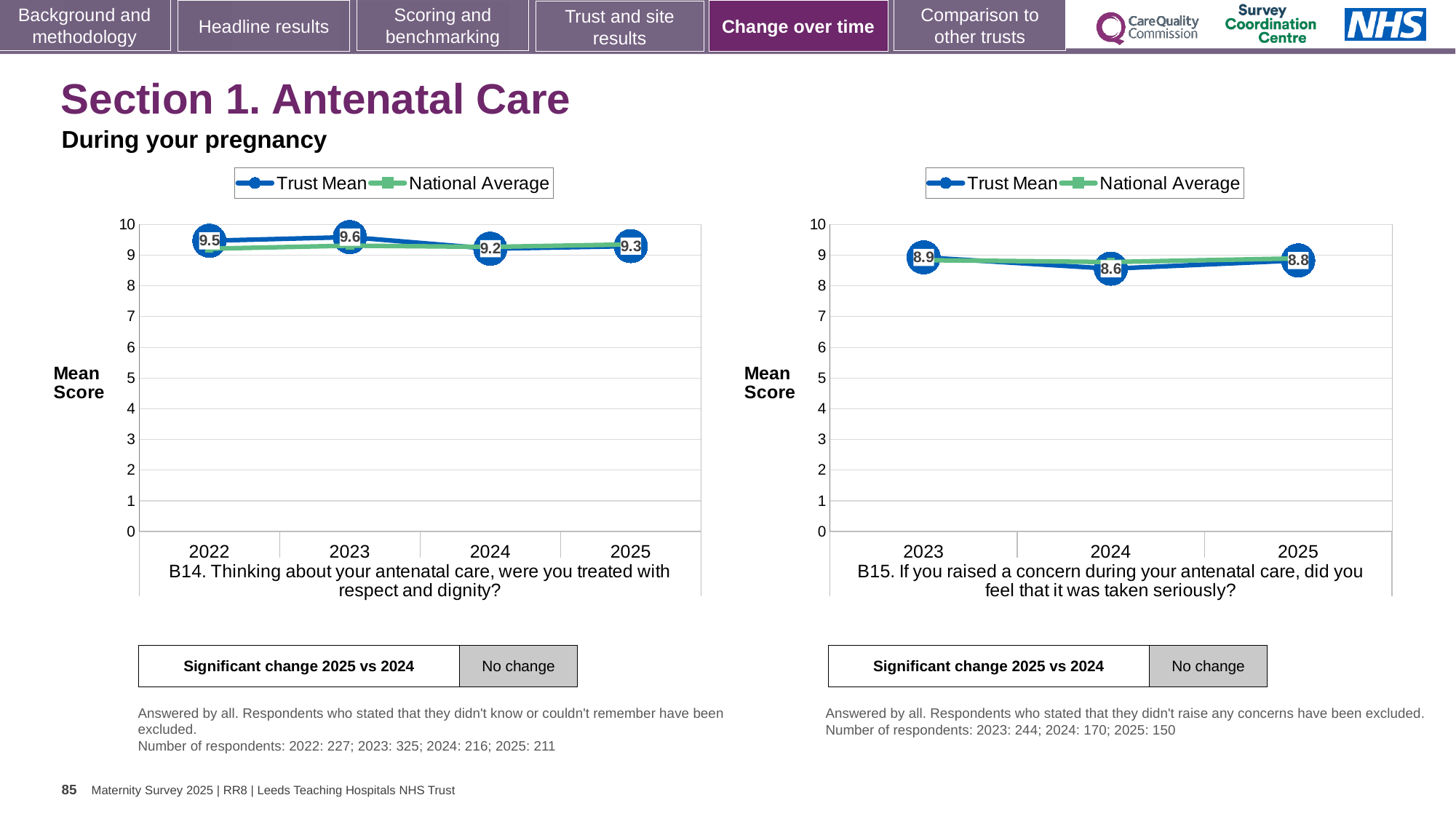
On the B14 chart (left), which year has the lowest Trust Mean? 2024 On the B14 chart (left), which year has the highest Trust Mean? 2023 On the B14 chart (left), what is the Trust Mean for 2023? 9.6 On the B15 chart (right), which year has the highest Trust Mean? 2023 On the B14 chart (left), what is the difference between the Trust Mean in 2023 and in 2024? 0.4 What kind of chart is the B14 chart (left)? Line chart On the B15 chart (right), what is the Trust Mean for 2024? 8.6 How many series does the legend of the B15 chart (right) list? 2 On the B15 chart (right), what is the Trust Mean for 2025? 8.8 On the B15 chart (right), is the Trust Mean for 2024 greater or less than 9? less On the B14 chart (left), what is the Trust Mean for 2024? 9.2 On the B14 chart (left), how many years are shown on the x axis? 4